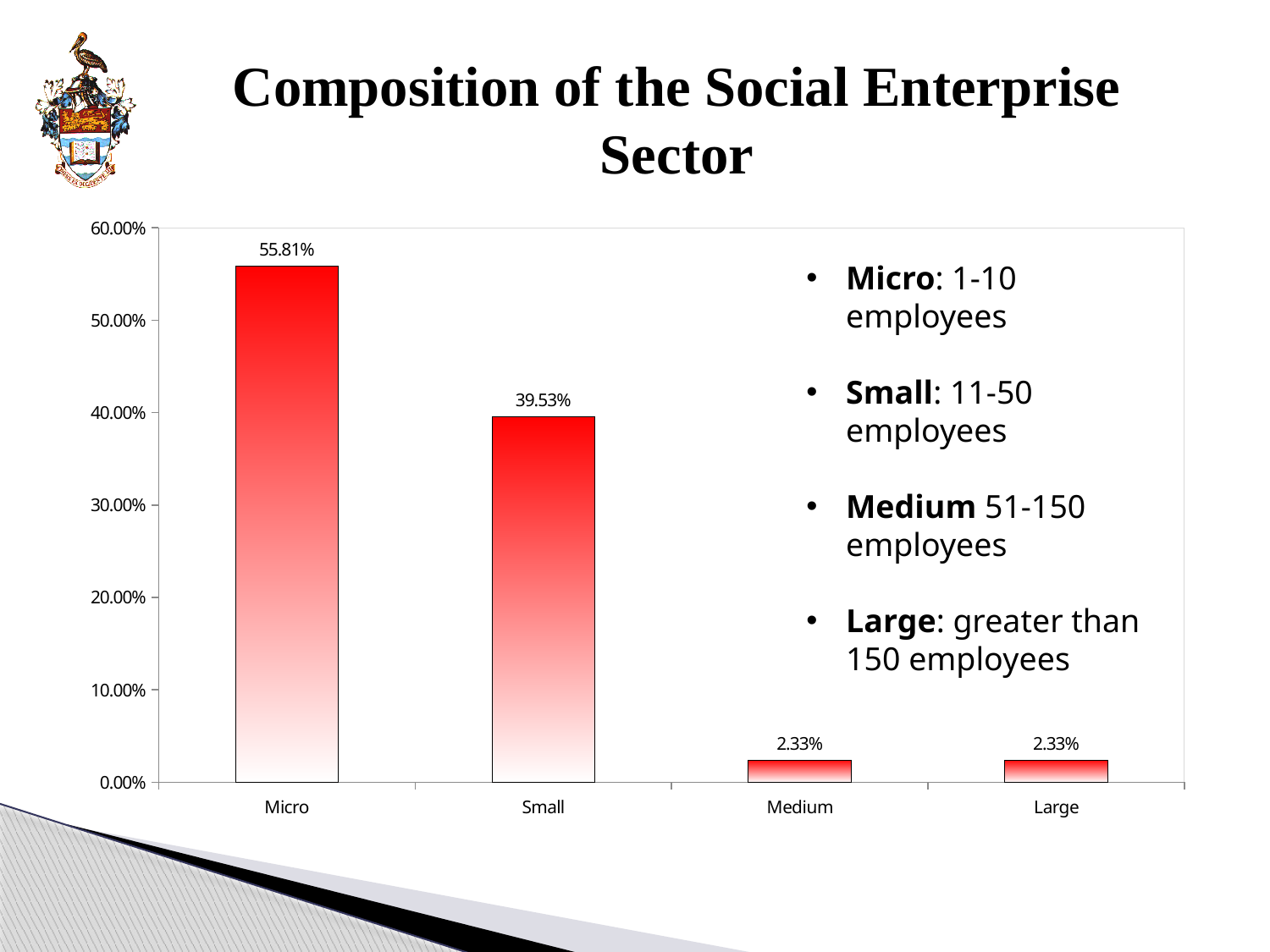
What is the value for Small? 39.53% What is the difference between the values for Micro and Small? 16.28% What is the value for Micro? 55.81% What is the title of the slide containing the chart? Composition of the Social Enterprise Sector What is the value for Medium? 2.33% Which is larger, the value for Small or the value for Medium? Small Which category has the highest value? Micro What kind of chart is shown on the slide? bar chart What is the value for Large? 2.33% How many categories are shown on the x axis? 4 Is the value for Small greater or less than 40.00%? less Do the values rise or fall from Micro to Medium along the x axis? fall